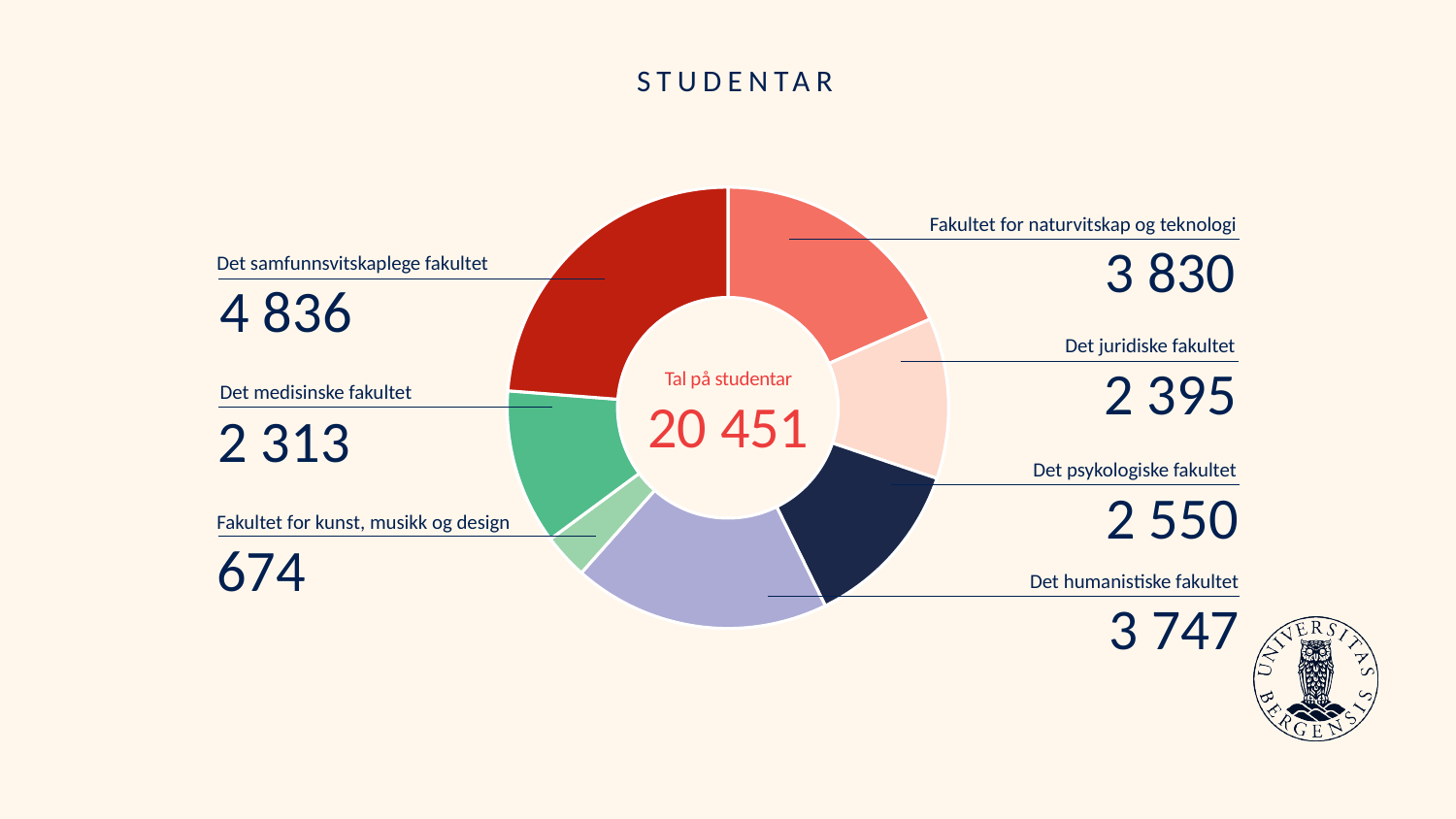
What is the difference between Det samfunnsvitskaplege fakultet and Det medisinske fakultet? 2 523 What kind of chart is shown on the slide? Donut (pie) chart Which faculty has the lowest number of students? Fakultet for kunst, musikk og design What total number is printed in the centre of the donut chart? 20 451 What is the value for Fakultet for kunst, musikk og design? 674 Which has more students, Det psykologiske fakultet or Det humanistiske fakultet? Det humanistiske fakultet What is the value for Fakultet for naturvitskap og teknologi? 3 830 What is the value for Det juridiske fakultet? 2 395 How many students does Det samfunnsvitskaplege fakultet have? 4 836 How many faculties are shown in the chart? 7 Which faculty has the highest number of students? Det samfunnsvitskaplege fakultet What is the title of the slide? STUDENTAR